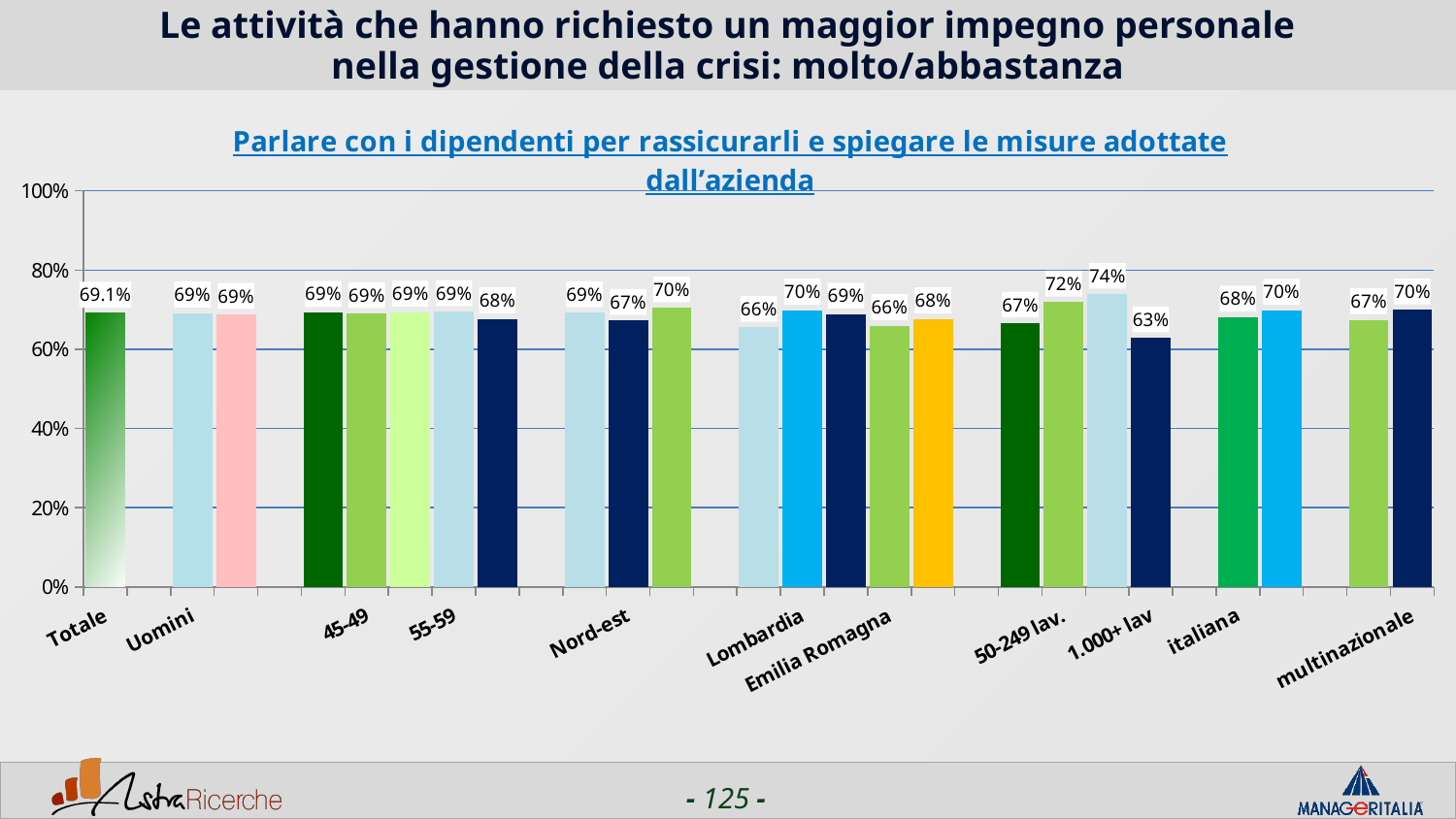
Is the value for italiana greater or less than 60%? greater Which is larger, the value for Lombardia or the value for Emilia Romagna? Lombardia What is the value for multinazionale? 70% What is the value for 1.000+ lav? 63% What is the value for 50-249 lav.? 72% Which category has the lowest value in the chart? 1.000+ lav What kind of chart is shown on the slide? Bar chart What is the value for Lombardia? 70% What is the value for Emilia Romagna? 66% What is the value for Nord-est? 67% What is the value for Totale? 69.1% What is the difference between the values for 50-249 lav. and 1.000+ lav? 9 percentage points